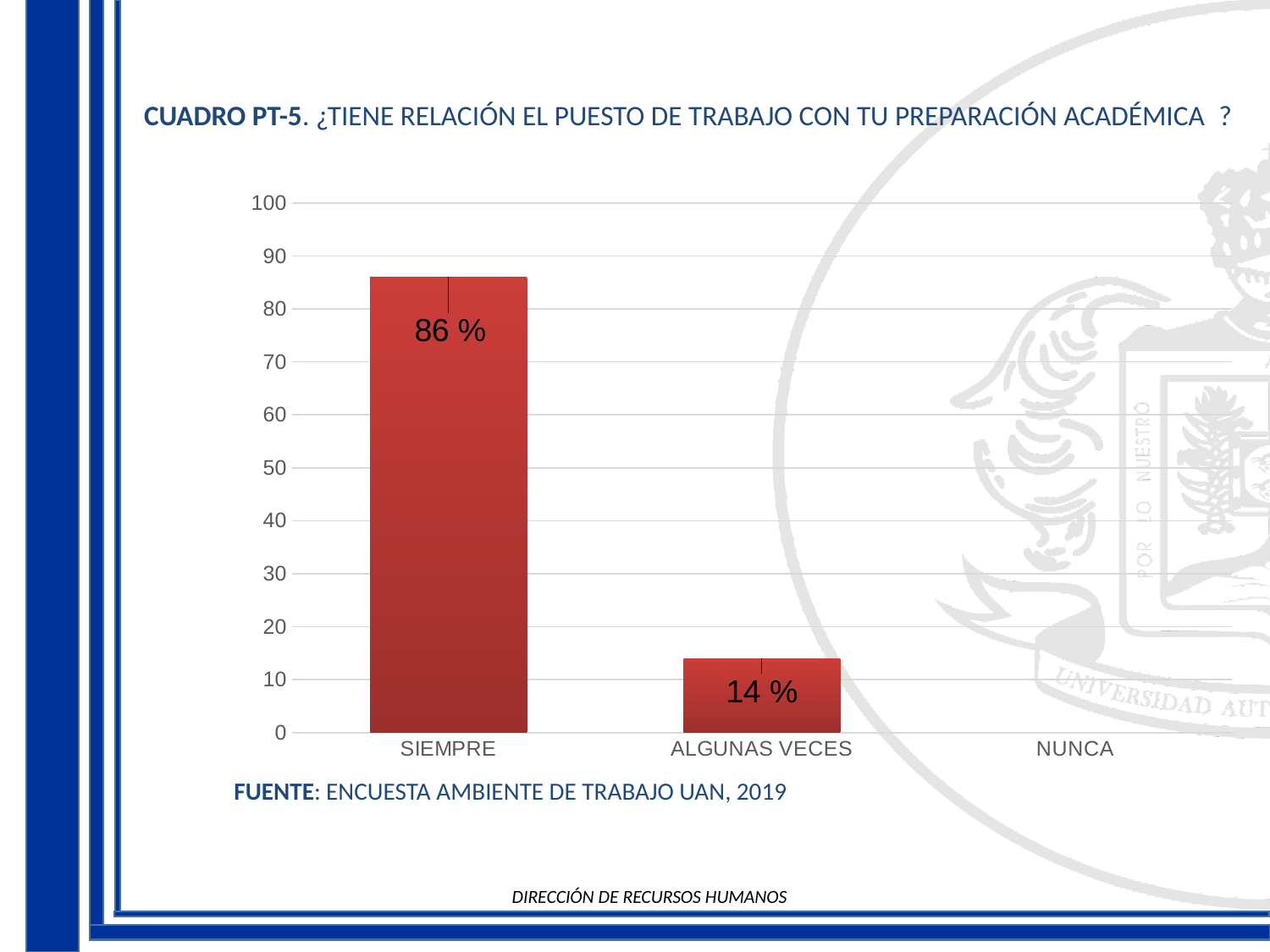
What is the source cited below the chart? ENCUESTA AMBIENTE DE TRABAJO UAN, 2019 How many categories are shown on the x axis? 3 Which is larger, the value for SIEMPRE or the value for ALGUNAS VECES? SIEMPRE What is the highest value shown on the y axis? 100 Which category has the lowest value among those with a visible bar? ALGUNAS VECES What is the difference between the values for SIEMPRE and ALGUNAS VECES? 72 % Which category has the highest value? SIEMPRE Is the value for ALGUNAS VECES greater or less than 20? less What is the value for ALGUNAS VECES? 14 % Is the value for SIEMPRE greater or less than 80? greater What is the value for SIEMPRE? 86 % What kind of chart is shown on the slide? Bar chart